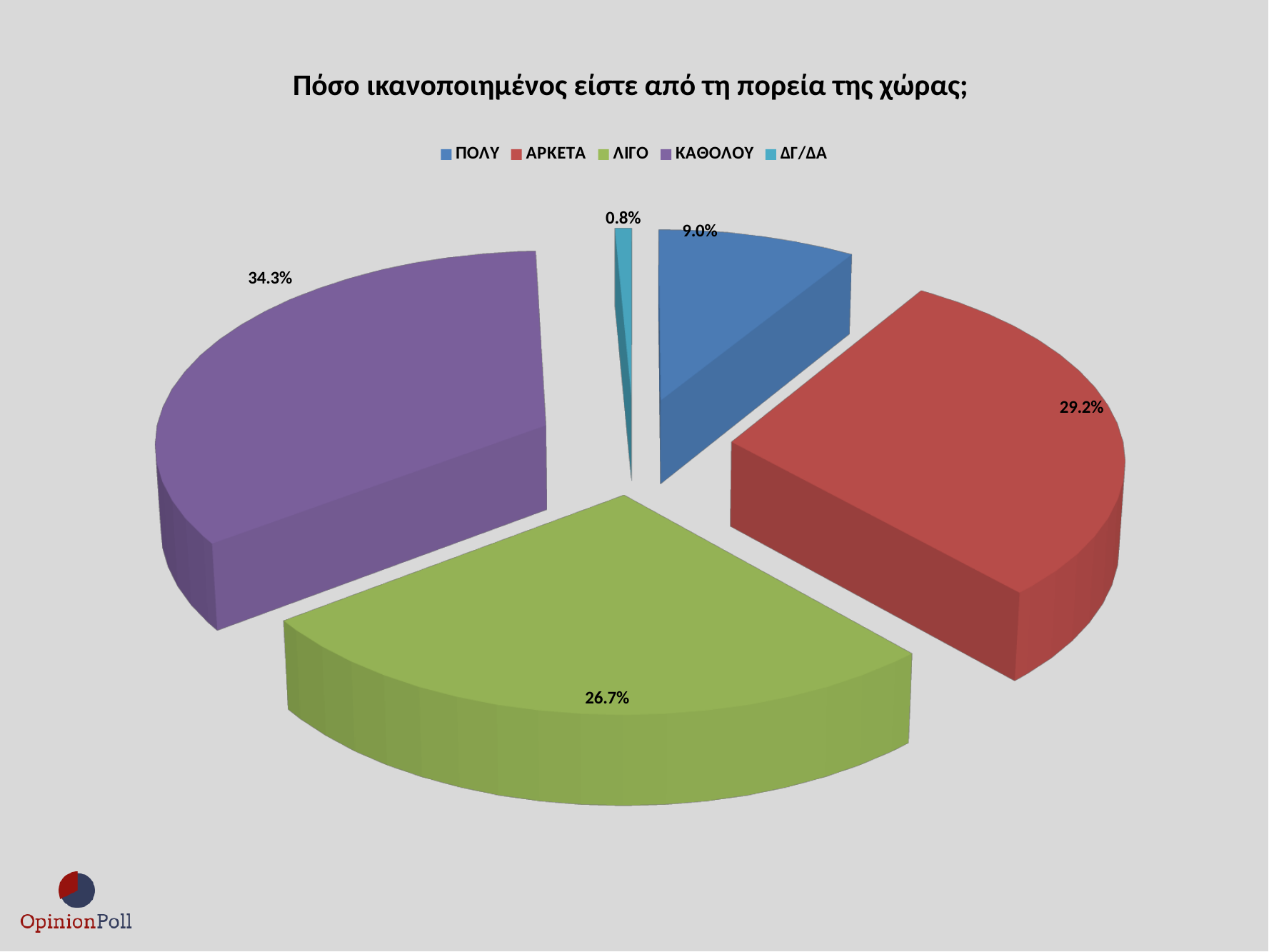
What is the value for ΑΡΚΕΤΑ? 29.2% What is the value for ΛΙΓΟ? 26.7% Which category has the largest share of the pie? ΚΑΘΟΛΟΥ What is the difference between the values for ΚΑΘΟΛΟΥ and ΠΟΛΥ? 25.3% What is the value for ΠΟΛΥ? 9.0% What is the value for ΔΓ/ΔΑ? 0.8% What is the value for ΚΑΘΟΛΟΥ? 34.3% How many categories does the legend list? 5 Which category has the smallest share of the pie? ΔΓ/ΔΑ Which is larger, the value for ΑΡΚΕΤΑ or the value for ΛΙΓΟ? ΑΡΚΕΤΑ What colour is the slice for ΛΙΓΟ? Green What kind of chart is shown on the slide? Pie chart